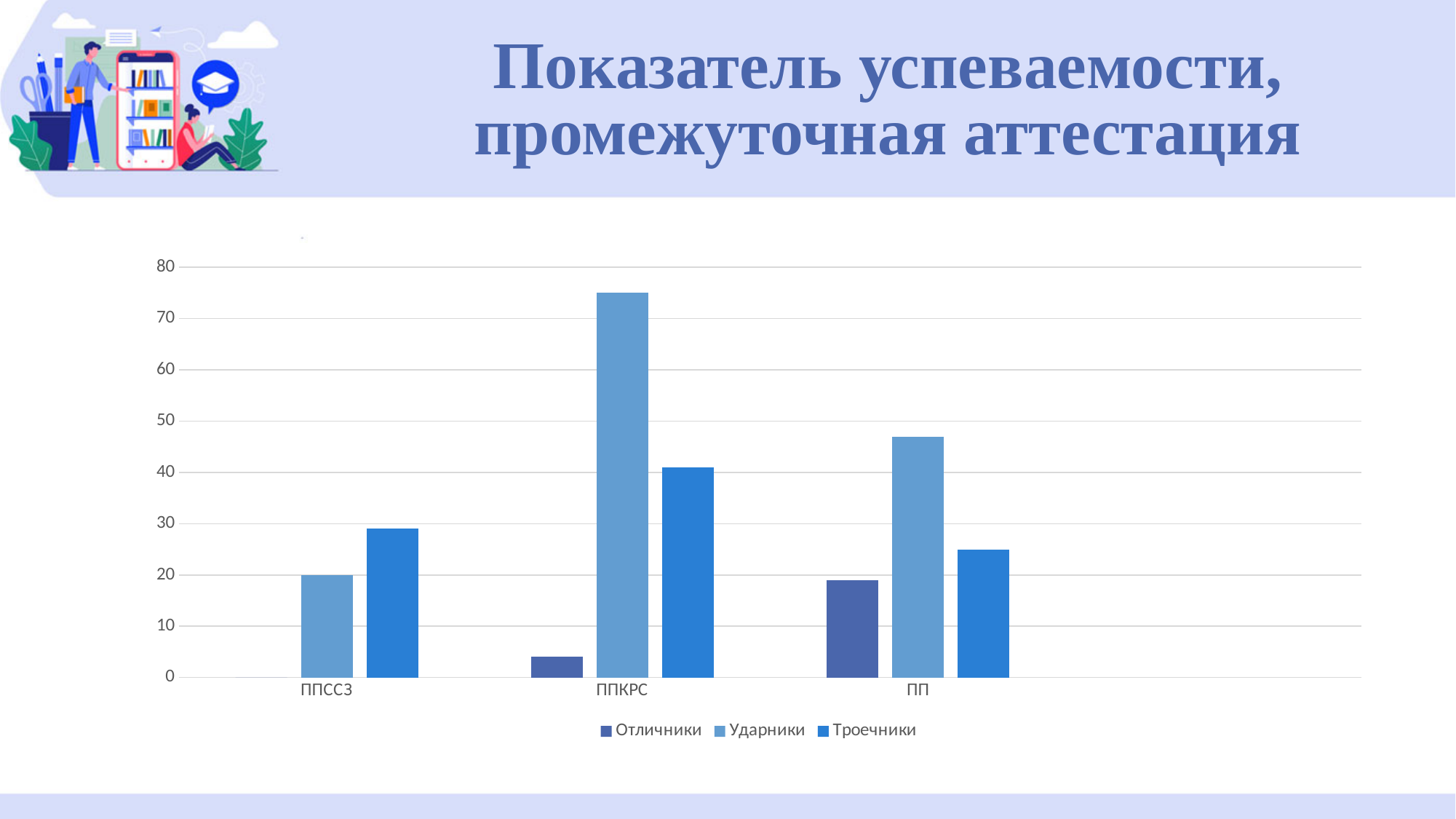
How many categories are shown on the x axis? 3 What are the three legend entries of the chart? Отличники, Ударники, Троечники Is the value for Ударники in ППКРС greater or less than 70? greater Which category has the highest value for Отличники? ПП Which category has the highest value for Ударники? ППКРС Which is larger in ПП: Ударники or Троечники? Ударники What kind of chart is shown on the slide? bar chart Is the value for Отличники in ППКРС greater or less than 10? less Which is larger for Троечники: ППКРС or ПП? ППКРС How many series does the legend list? 3 Which category has the lowest value for Троечники? ПП